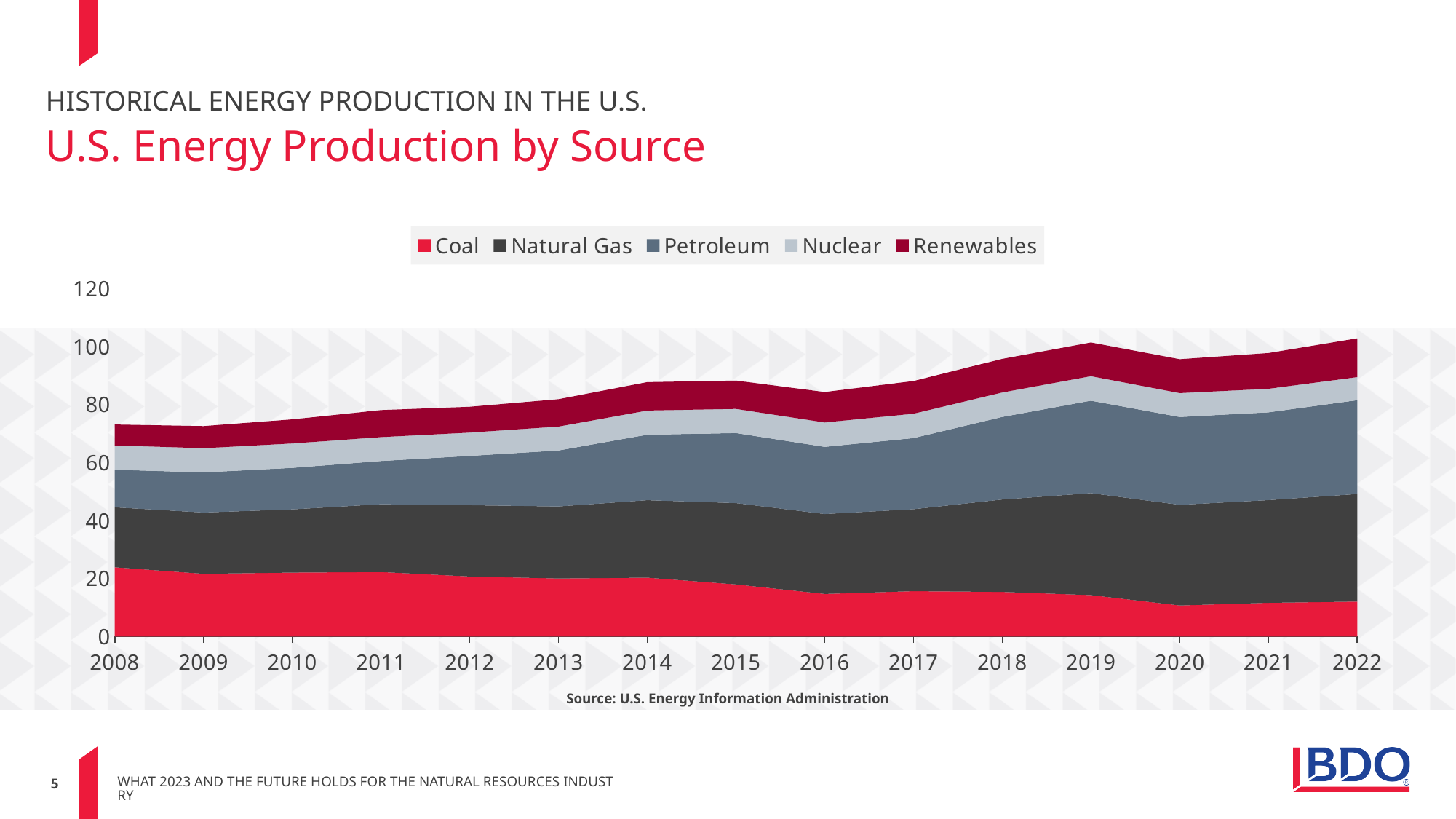
How many series does the legend list? 5 Which series is plotted at the top of the stack? Renewables Is the value for Coal in 2022 greater or less than 20? less Is the total energy production in 2016 greater or less than 80? greater Does the total energy production rise or fall from 2008 to 2022? Rise Is the total energy production in 2008 greater or less than 80? less Does the Coal series rise or fall from 2008 to 2022? Fall What kind of chart is shown on the slide? Stacked area chart Which series is plotted at the bottom of the stack? Coal How many years are shown along the x axis? 15